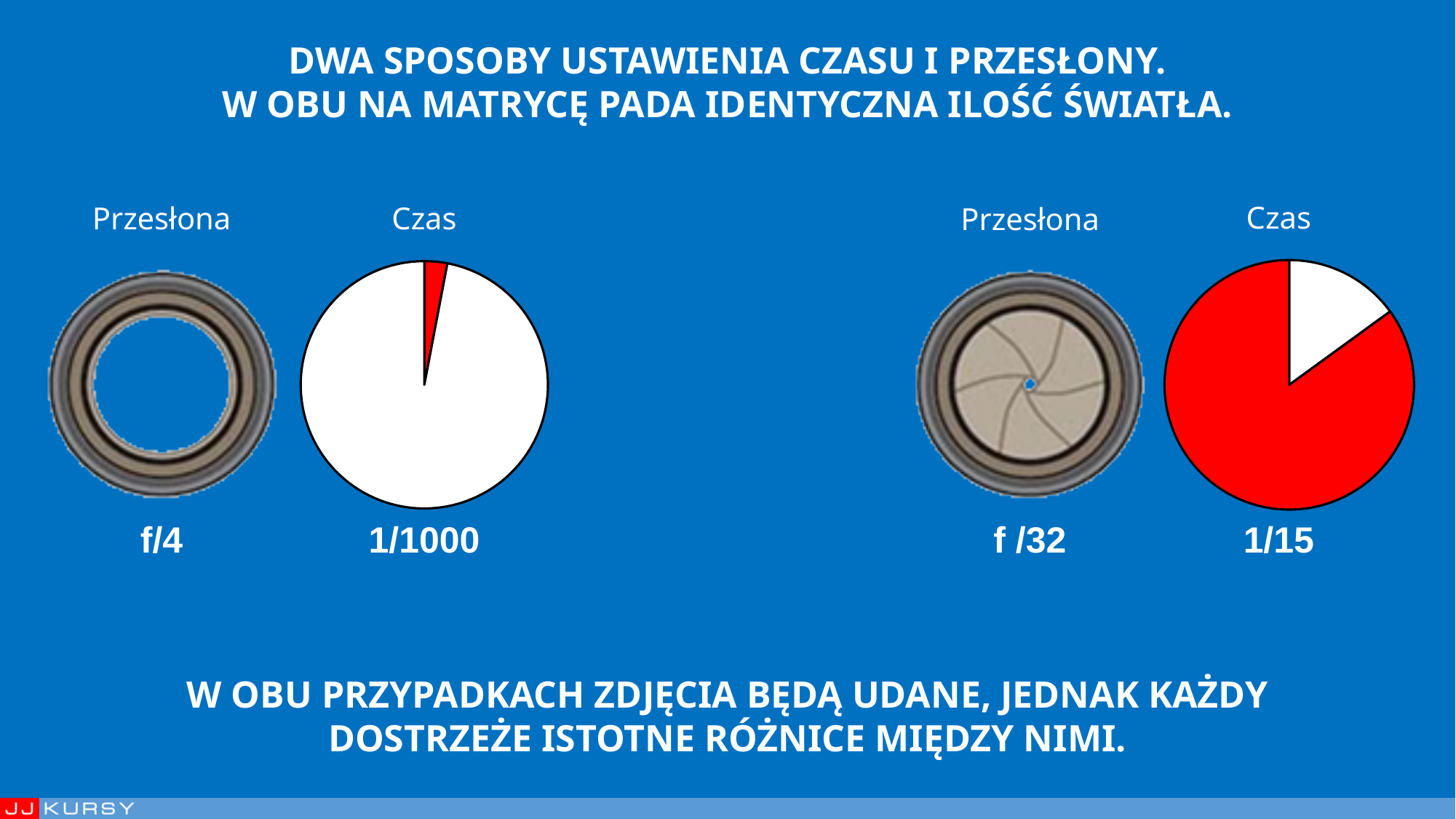
What two colours are used for the slices in the "Czas" pie charts? red and white How many pie charts are shown on the slide? 2 In the right "Czas" pie chart, which colour covers the larger share, red or white? red What value is printed below the left "Czas" pie chart? 1/1000 In the right "Czas" pie chart, is the red slice greater or less than half of the pie? greater Which "Czas" pie chart, left or right, has the larger red slice? right What value is printed below the right "Czas" pie chart? 1/15 In the left "Czas" pie chart, is the red slice greater or less than half of the pie? less How many slices does each "Czas" pie chart have? 2 What kind of chart is used under the "Czas" labels on the slide? pie chart In the left "Czas" pie chart, which colour covers the larger share, red or white? white What label appears above each pie chart on the slide? Czas